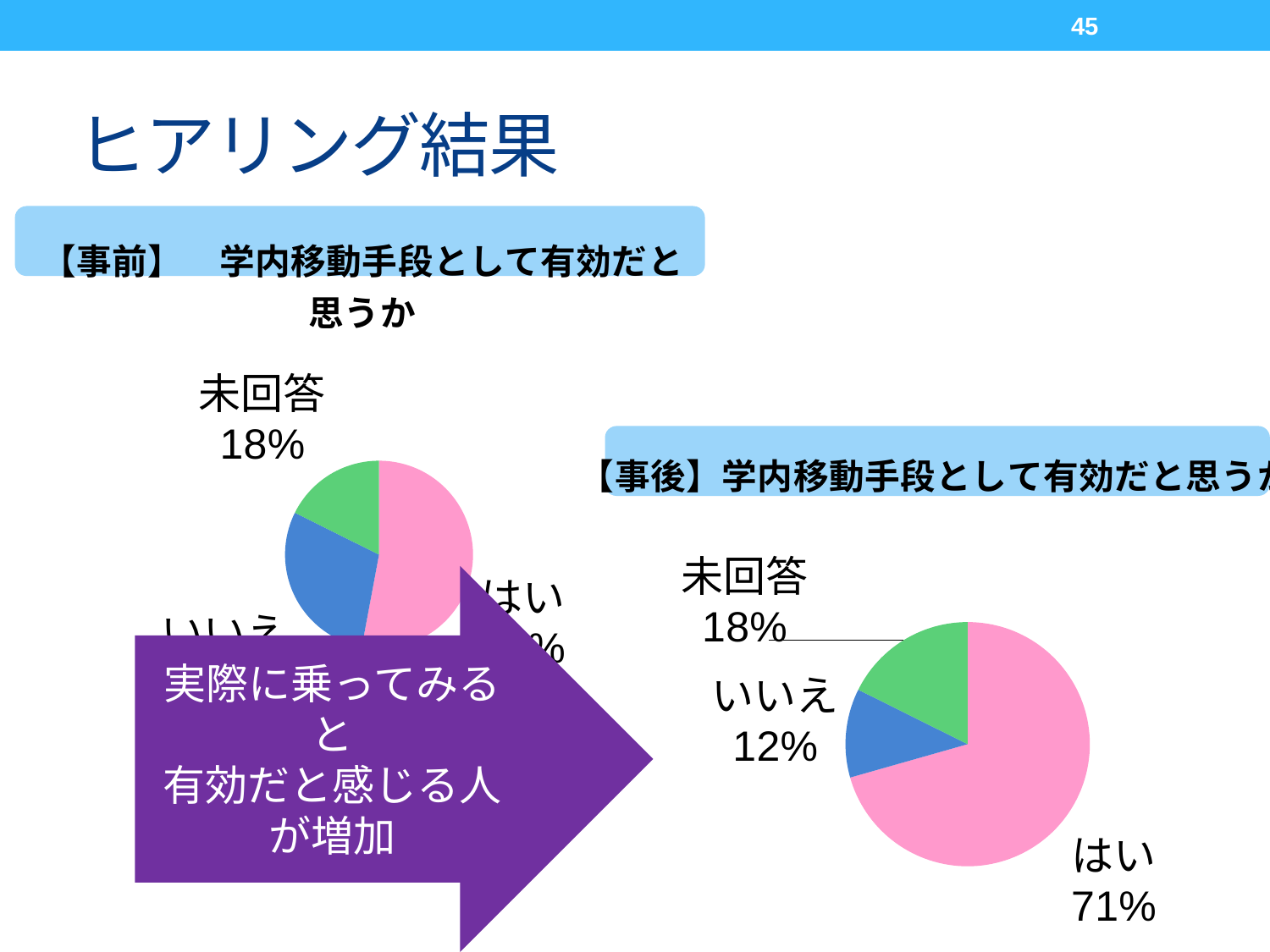
In the right pie chart (【事後】), what is the value for いいえ? 12% In the left pie chart (【事前】), what is the value for 未回答? 18% In the left pie chart (【事前】), which category has the largest share? はい In the right pie chart (【事後】), which is larger, 未回答 or いいえ? 未回答 In the right pie chart (【事後】), what is the value for はい? 71% In the right pie chart (【事後】), which category has the smallest share? いいえ In the right pie chart (【事後】), what is the difference between the はい and いいえ shares? 59% In the right pie chart (【事後】), what is the value for 未回答? 18% How many categories does the right pie chart (【事後】) show? 3 In the right pie chart (【事後】), what is the difference between the 未回答 and いいえ shares? 6% In the right pie chart (【事後】), which category has the largest share? はい What type of chart is used on this slide? Pie chart